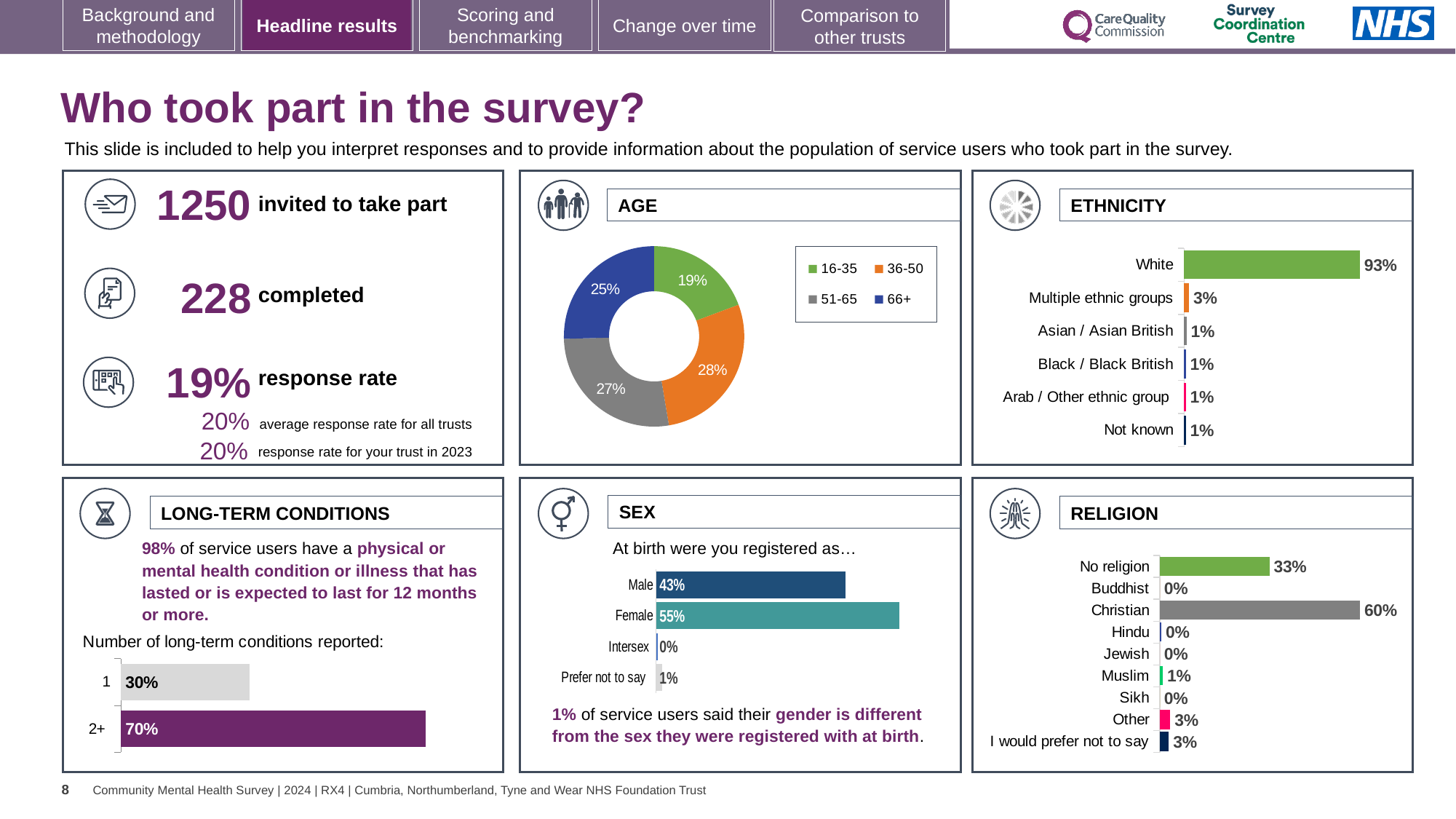
How many categories does the ETHNICITY chart show? 6 In the RELIGION chart, which category has the highest value? Christian In the AGE chart, which age group has the smallest share? 16-35 What kind of chart is the AGE chart? Doughnut chart In the AGE chart, what share of respondents are aged 36-50? 28% In the SEX chart, which is larger, Male or Female? Female In the SEX chart, what is the value for Prefer not to say? 1% In the ETHNICITY chart, what is the value for White? 93% In the ETHNICITY chart, what is the difference between White and Multiple ethnic groups? 90% In the RELIGION chart, what is the difference between Christian and No religion? 27% In the LONG-TERM CONDITIONS chart, what is the value for 2+ conditions? 70% How many entries does the legend of the AGE chart list? 4